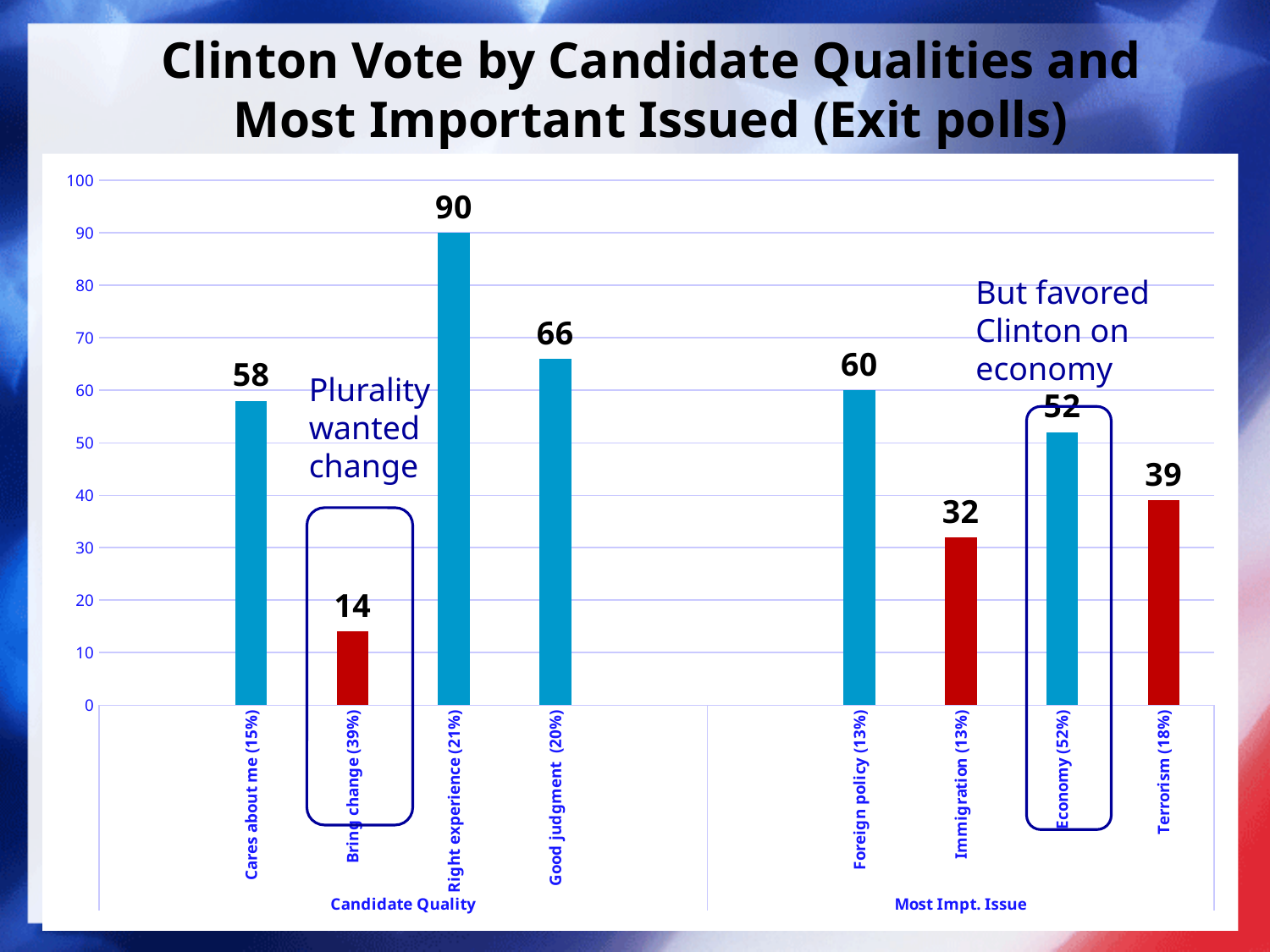
How many categories are plotted in the chart? 8 What is the difference between the values for Right experience (21%) and Good judgment (20%)? 24 What is the value for Right experience (21%)? 90 Which category has the highest value? Right experience (21%) Which category has the lowest value? Bring change (39%) What are the two group labels shown along the x axis? Candidate Quality and Most Impt. Issue What is the value for Economy (52%)? 52 What is the value for Immigration (13%)? 32 What is the value for Bring change (39%)? 14 What kind of chart is shown on the slide? Bar chart What is the difference between the values for Foreign policy (13%) and Terrorism (18%)? 21 Which is larger, the value for Cares about me (15%) or the value for Economy (52%)? Cares about me (15%)